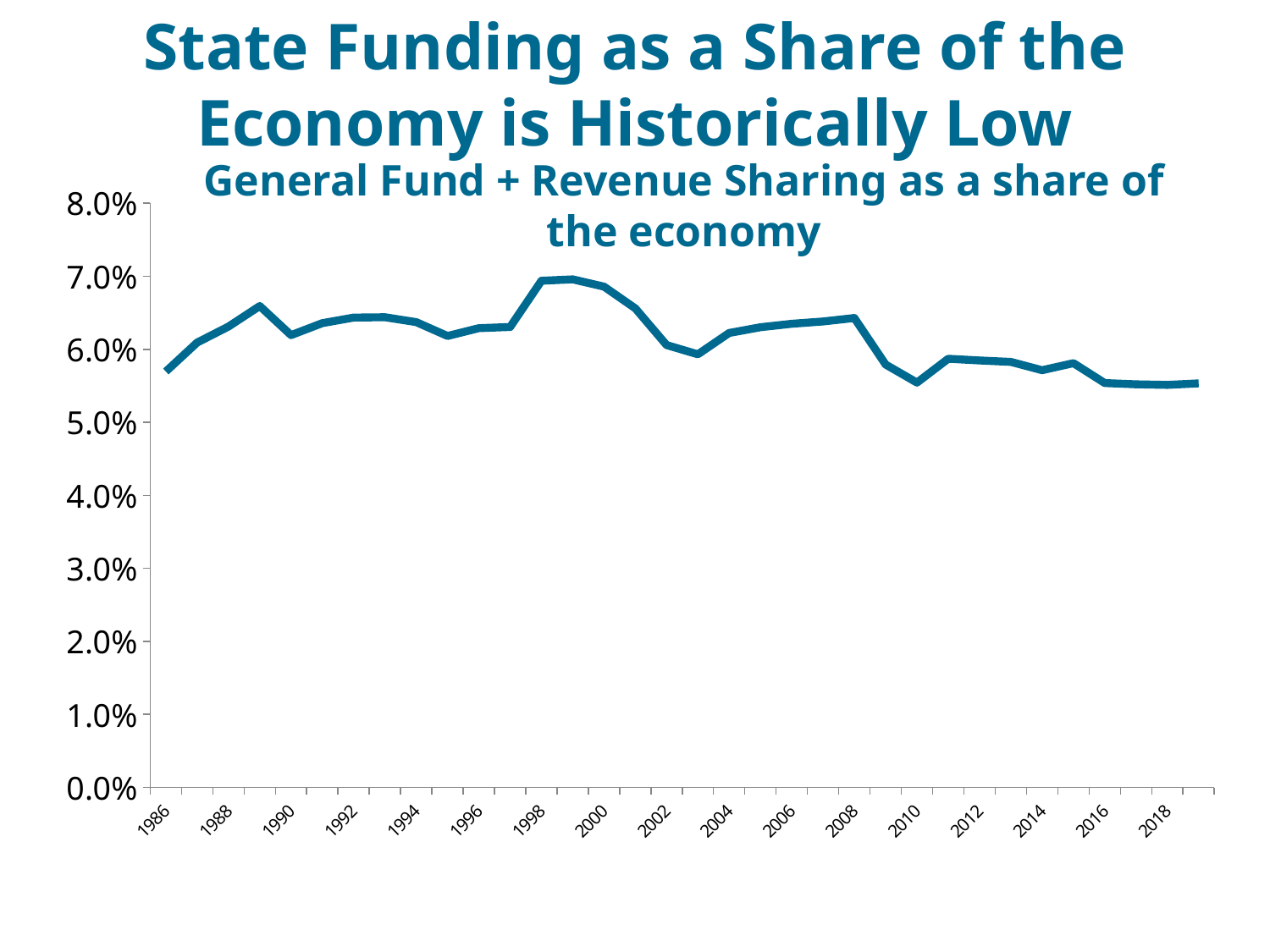
What is the title of the chart? General Fund + Revenue Sharing as a share of the economy Is the value for 2018 greater or less than 6.0%? less What kind of chart is shown on the slide? line chart Is the value for 1986 greater or less than 6.0%? less Is the value for 2008 greater or less than 6.0%? greater Which year has the larger value, 1989 or 2010? 1989 What is the highest value shown on the vertical axis? 8.0% Does the value rise or fall from 2008 to 2010? fall Does the value rise or fall from 1986 to 1989? rise Which year has the larger value, 1999 or 2016? 1999